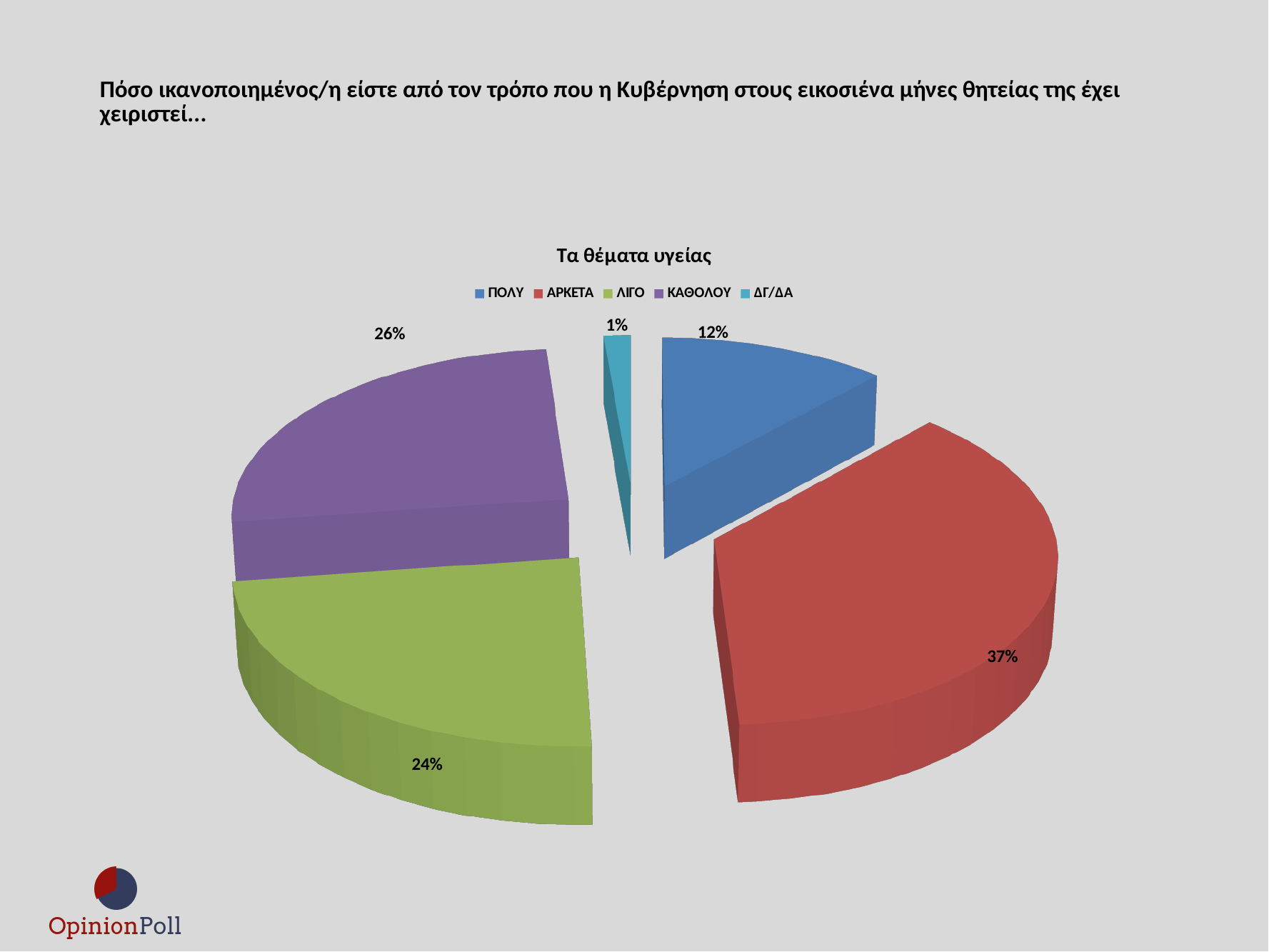
What is the title of the chart? Τα θέματα υγείας What type of chart is shown on the slide? Pie chart What is the value for ΔΓ/ΔΑ? 1% Which category has the smallest share? ΔΓ/ΔΑ Which category has the largest share? ΑΡΚΕΤΑ Which is larger, the value for ΚΑΘΟΛΟΥ or the value for ΛΙΓΟ? ΚΑΘΟΛΟΥ What is the value for ΑΡΚΕΤΑ? 37% How many categories does the legend list? 5 What is the difference between the values for ΑΡΚΕΤΑ and ΠΟΛΥ? 25% What is the value for ΠΟΛΥ? 12% What is the value for ΛΙΓΟ? 24% What is the value for ΚΑΘΟΛΟΥ? 26%